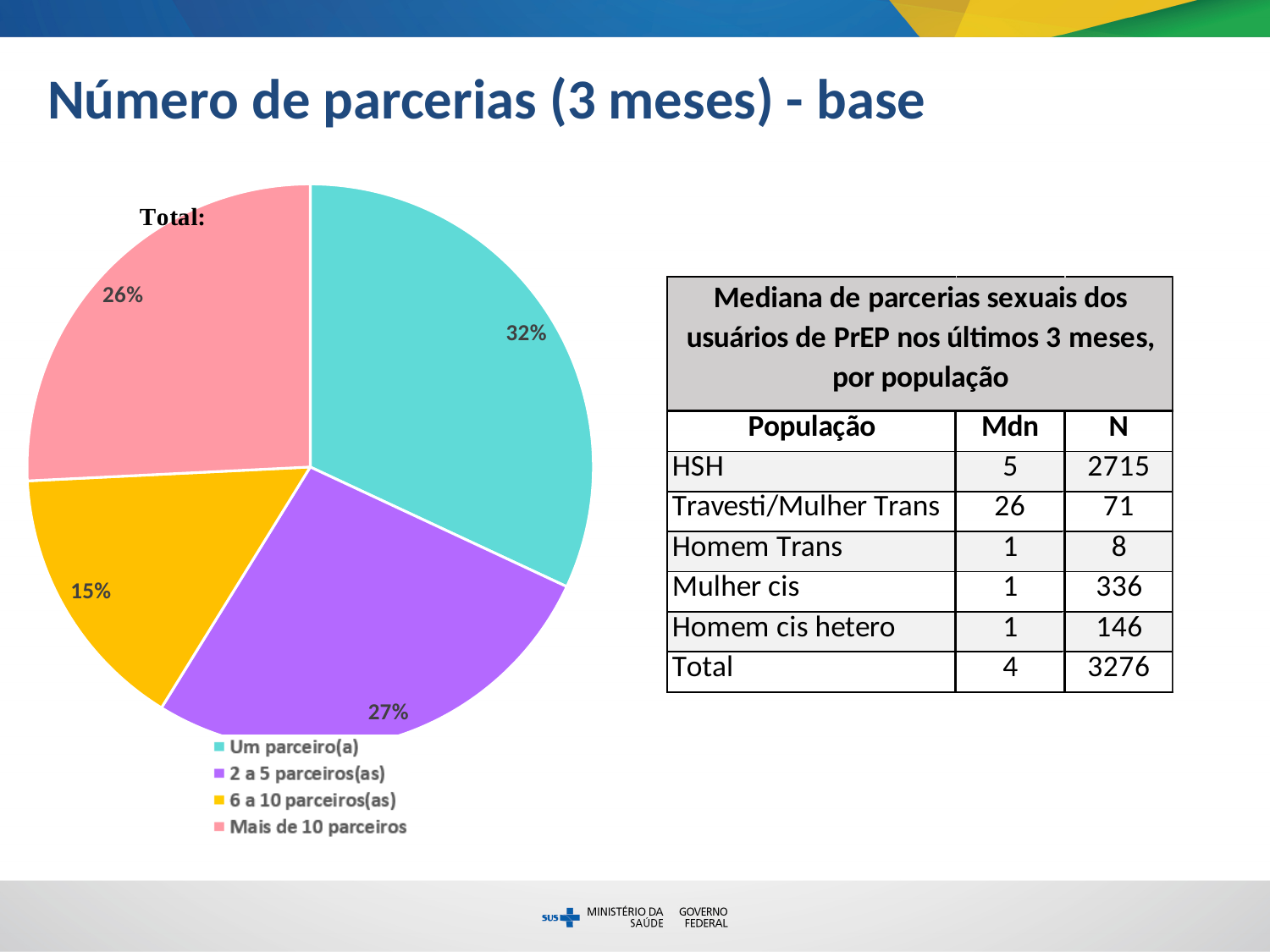
What share of the pie chart is labelled "2 a 5 parceiros(as)"? 27% What colour is the "Mais de 10 parceiros" slice in the pie chart? pink How many slices does the pie chart have? 4 What share of the pie chart is labelled "6 a 10 parceiros(as)"? 15% What share of the pie chart is labelled "Mais de 10 parceiros"? 26% How many entries does the pie chart legend list? 4 What kind of chart is shown on the slide? pie chart What is the difference in percentage points between the "Um parceiro(a)" slice and the "6 a 10 parceiros(as)" slice? 17 Which category has the smallest slice in the pie chart? 6 a 10 parceiros(as) Which slice is larger: "2 a 5 parceiros(as)" or "Mais de 10 parceiros"? 2 a 5 parceiros(as) Which category has the largest slice in the pie chart? Um parceiro(a)